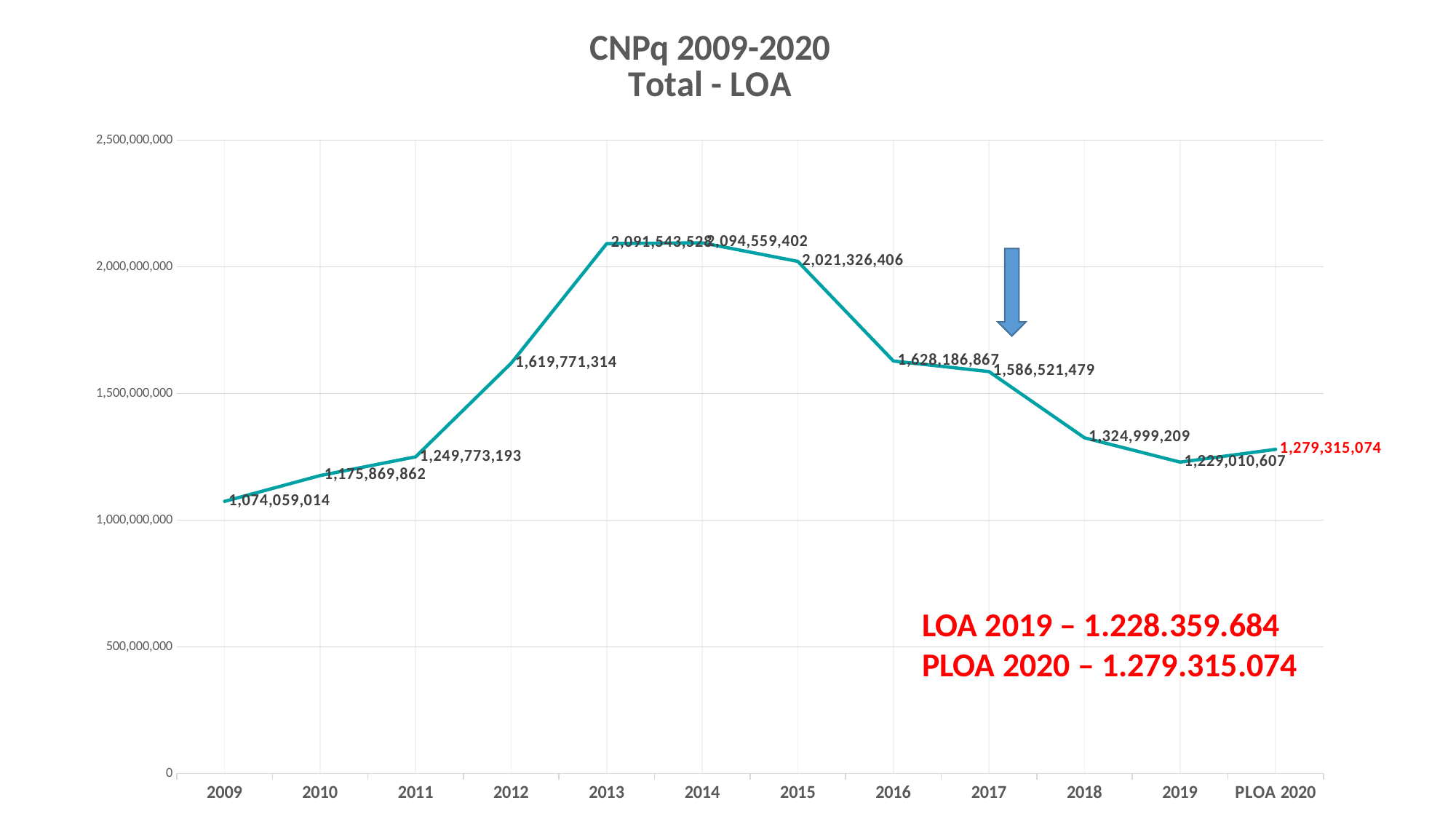
What is the difference between the values for 2016 and 2017? 41,665,388 How many data points are plotted on the line? 12 Do the values rise or fall from 2014 to 2019? fall What is the value for PLOA 2020? 1,279,315,074 What kind of chart is shown? line chart Is the value for 2012 greater or less than 1,500,000,000? greater What is the difference between the values for 2018 and 2019? 95,988,602 What is the value for 2018? 1,324,999,209 What is the value for 2015? 2,021,326,406 Which is larger, the value for 2012 or the value for 2016? 2016 What is the value for 2009? 1,074,059,014 Which year has the lowest value? 2009